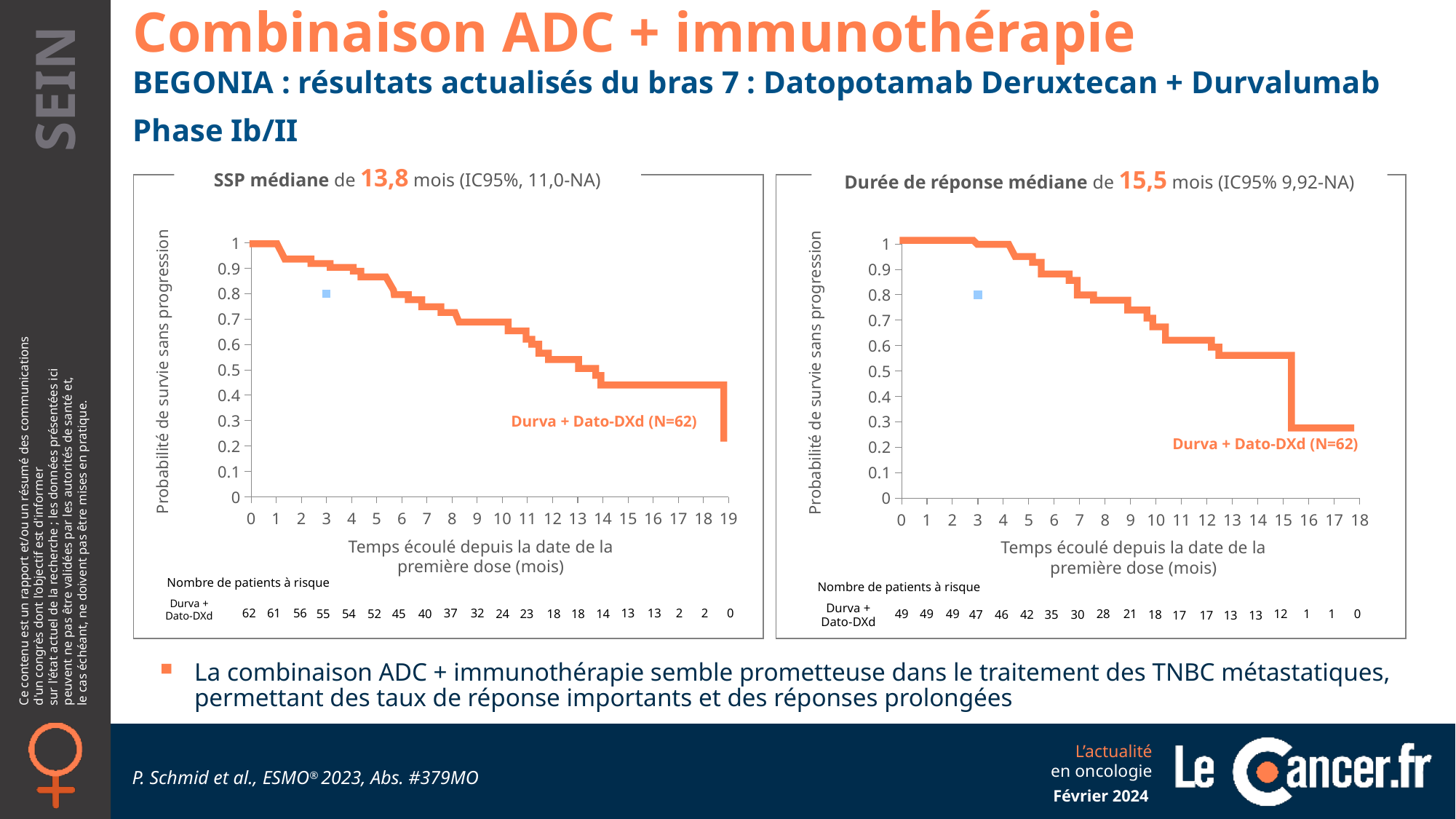
What kind of chart is the left chart titled 'SSP médiane'? line chart On the right chart (Durée de réponse médiane), what is the difference between the number of patients at risk at month 0 and at month 9? 28 How many series are plotted on the right chart (Durée de réponse médiane)? 1 On the left chart (SSP médiane), how many patients are at risk at month 10? 24 On the left chart (SSP médiane), how many patients are at risk at month 0? 62 On the left chart (SSP médiane), does the curve rise or fall as time since first dose increases? fall On the right chart (Durée de réponse médiane), how many patients are at risk at month 5? 42 At month 3, which chart shows more patients at risk: the left chart (SSP médiane) or the right chart (Durée de réponse médiane)? the left chart (SSP médiane) On the left chart (SSP médiane), what is the median progression-free survival stated in the title? 13,8 mois On the right chart (Durée de réponse médiane), what is the median duration of response stated in the title? 15,5 mois On the left chart (SSP médiane), is the survival probability at month 16 greater or less than 0.5? less On the right chart (Durée de réponse médiane), is the survival probability at month 10 greater or less than 0.5? greater